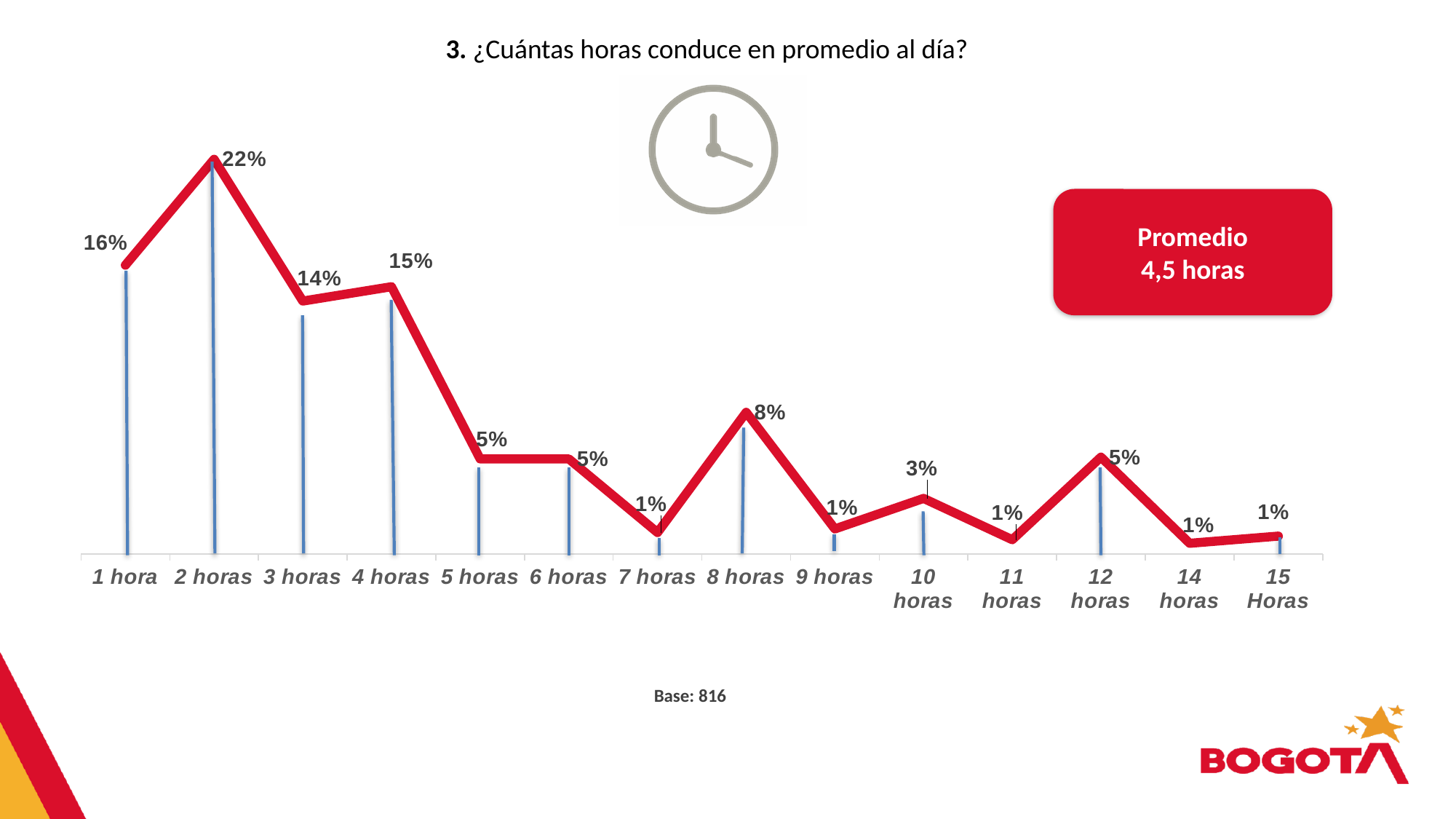
Which category has the highest value? 2 horas What kind of chart is shown on the slide? Line chart What is the difference between the values for 2 horas and 3 horas? 8% What is the difference between the values for 4 horas and 5 horas? 10% Which is larger, the value for 8 horas or the value for 12 horas? 8 horas How many categories are plotted on the x axis? 14 Which is larger, the value for 3 horas or the value for 4 horas? 4 horas What percentage of respondents drive 2 horas per day on average? 22% What average number of hours is shown in the red box on the slide? 4,5 horas What is the value shown for 8 horas? 8% What is the value shown for 10 horas? 3% What is the value shown for 1 hora? 16%